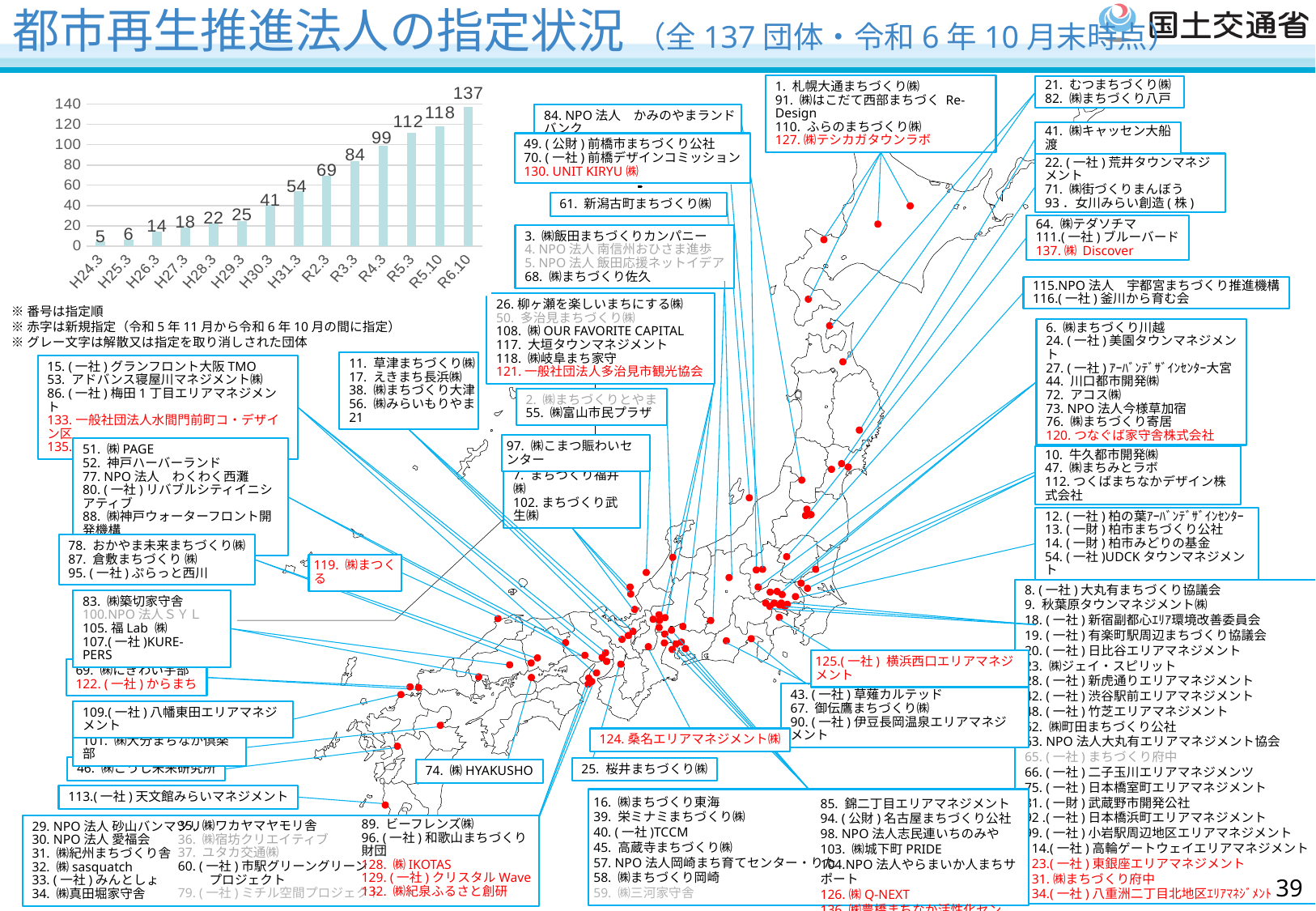
Is the value for R4.3 in the bar chart greater or less than 80? greater How many categories are shown on the x axis of the bar chart? 14 What kind of chart is shown in the top-left of the slide? bar chart What value does the bar chart show for R6.10? 137 Which is larger in the bar chart, the value for R2.3 or the value for H29.3? R2.3 What is the difference between the values for R6.10 and R5.10 in the bar chart? 19 What value does the bar chart show for H30.3? 41 Which category in the bar chart has the highest value? R6.10 Do the values in the bar chart rise or fall from H24.3 to R6.10? rise What is the difference between the values for H31.3 and H30.3 in the bar chart? 13 Which category in the bar chart has the lowest value? H24.3 What value does the bar chart show for R3.3? 84